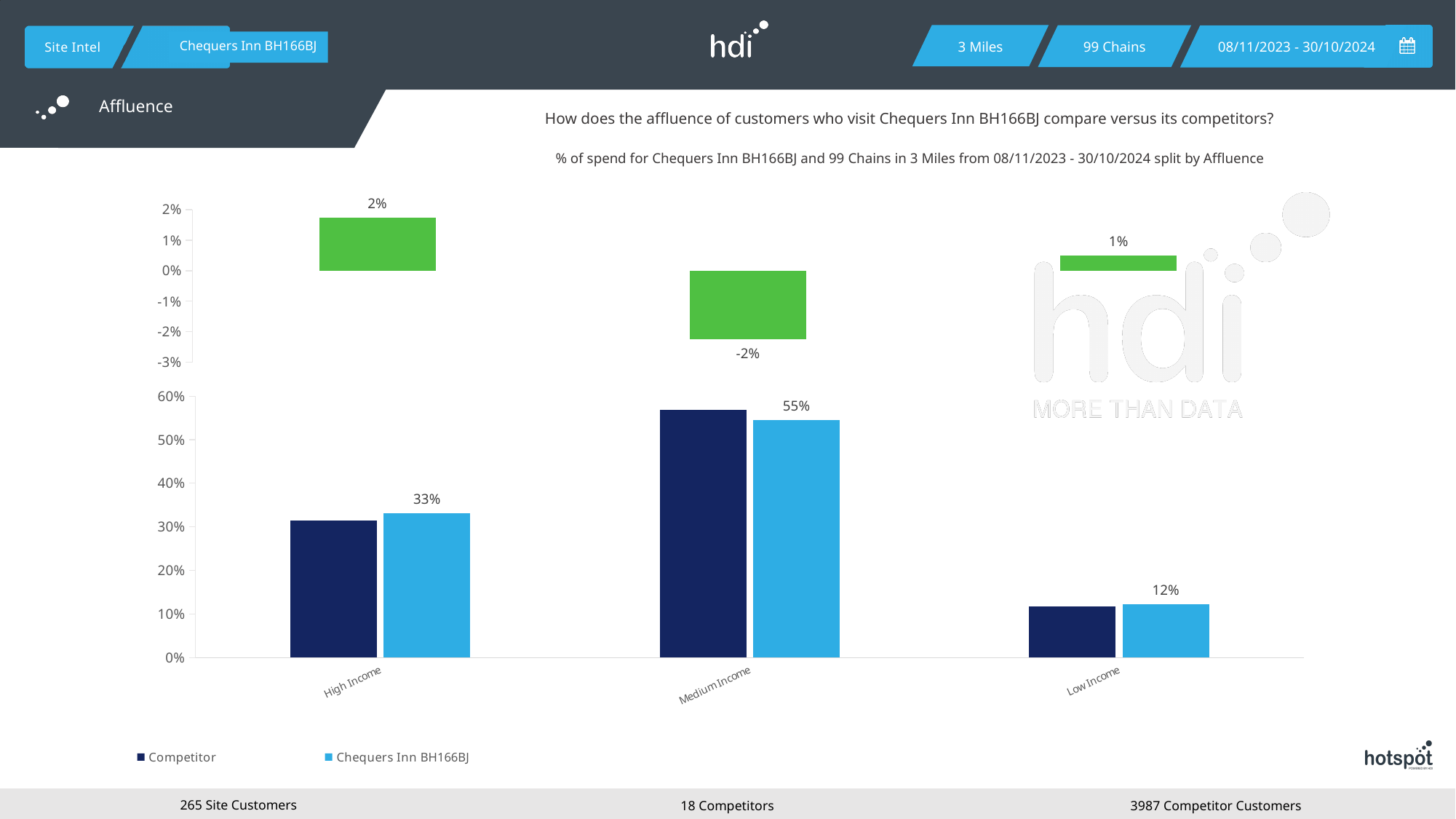
What kind of chart is the bottom chart? Bar chart In the bottom chart, which category has the highest value for Chequers Inn BH166BJ? Medium Income In the top chart, what is the value shown for the High Income category? 2% In the bottom chart, is the Competitor value for Low Income greater or less than 20%? less In the bottom chart, what is the value for Chequers Inn BH166BJ in the High Income category? 33% In the bottom chart, what is the value for Chequers Inn BH166BJ in the Low Income category? 12% In the bottom chart, what is the difference between the Chequers Inn BH166BJ values for Medium Income and High Income? 22% In the bottom chart, is the Competitor value for Medium Income greater or less than 50%? greater How many series does the legend of the bottom chart list? 2 In the bottom chart, what is the value for Chequers Inn BH166BJ in the Medium Income category? 55% In the top chart, what is the value shown for the Medium Income category? -2% In the bottom chart, which category has the lowest value for Chequers Inn BH166BJ? Low Income